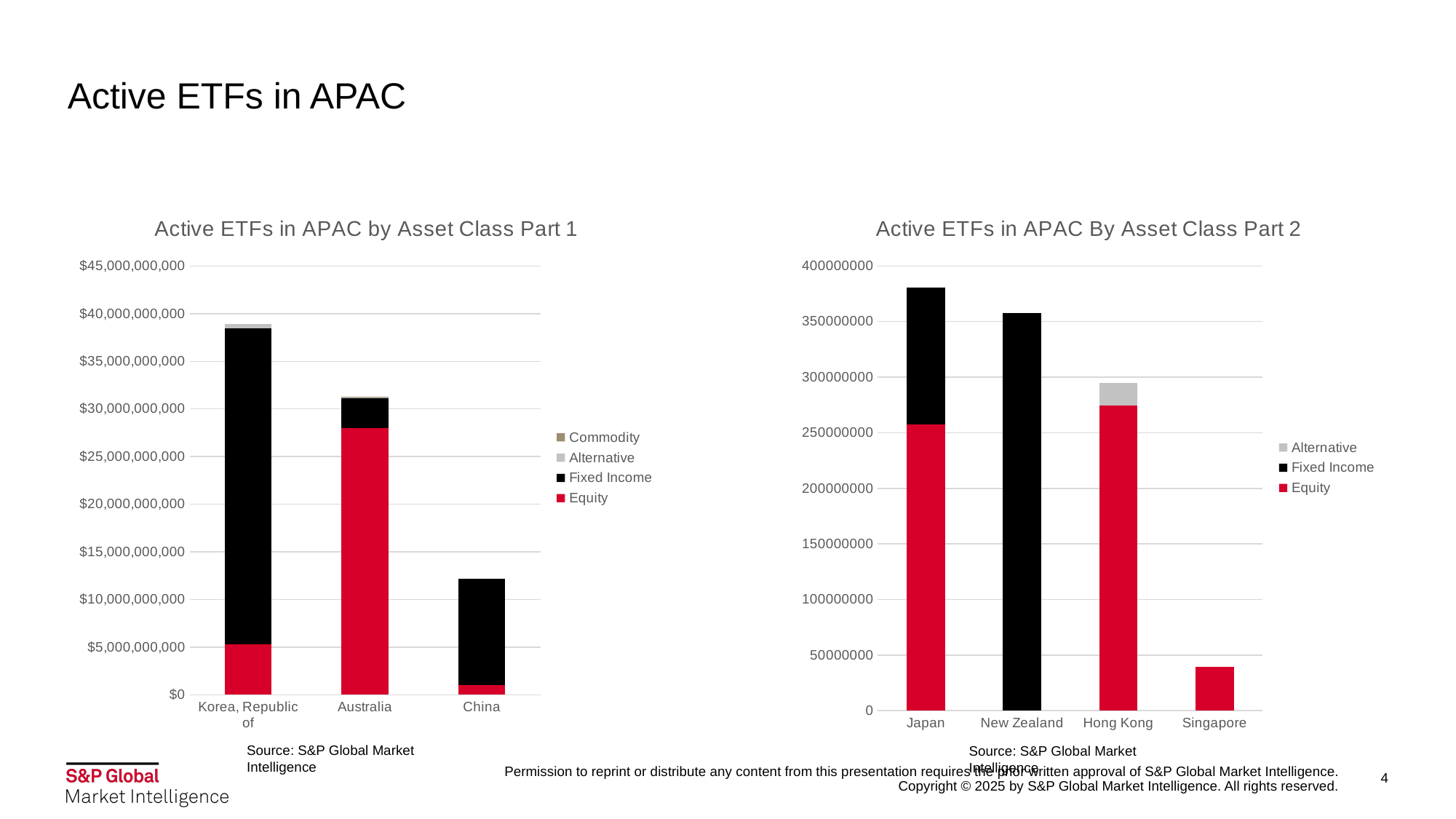
In 'Active ETFs in APAC by Asset Class Part 1', is the total bar for Australia greater or less than $30,000,000,000? greater What type of chart is 'Active ETFs in APAC by Asset Class Part 1'? Stacked bar chart In 'Active ETFs in APAC by Asset Class Part 1', how many countries are shown on the x axis? 3 In 'Active ETFs in APAC by Asset Class Part 1', is the total bar for China greater or less than $15,000,000,000? less In 'Active ETFs in APAC By Asset Class Part 2', which country has the highest total bar? Japan In 'Active ETFs in APAC by Asset Class Part 1', which country has the highest total bar? Korea, Republic of In 'Active ETFs in APAC by Asset Class Part 1', which country has the lowest total bar? China In 'Active ETFs in APAC By Asset Class Part 2', is the total bar for Singapore greater or less than 50000000? less In 'Active ETFs in APAC By Asset Class Part 2', which is larger, the total bar for Japan or for New Zealand? Japan How many series does the legend of 'Active ETFs in APAC By Asset Class Part 2' list? 3 How many series does the legend of 'Active ETFs in APAC by Asset Class Part 1' list? 4 In 'Active ETFs in APAC By Asset Class Part 2', which country has the lowest total bar? Singapore